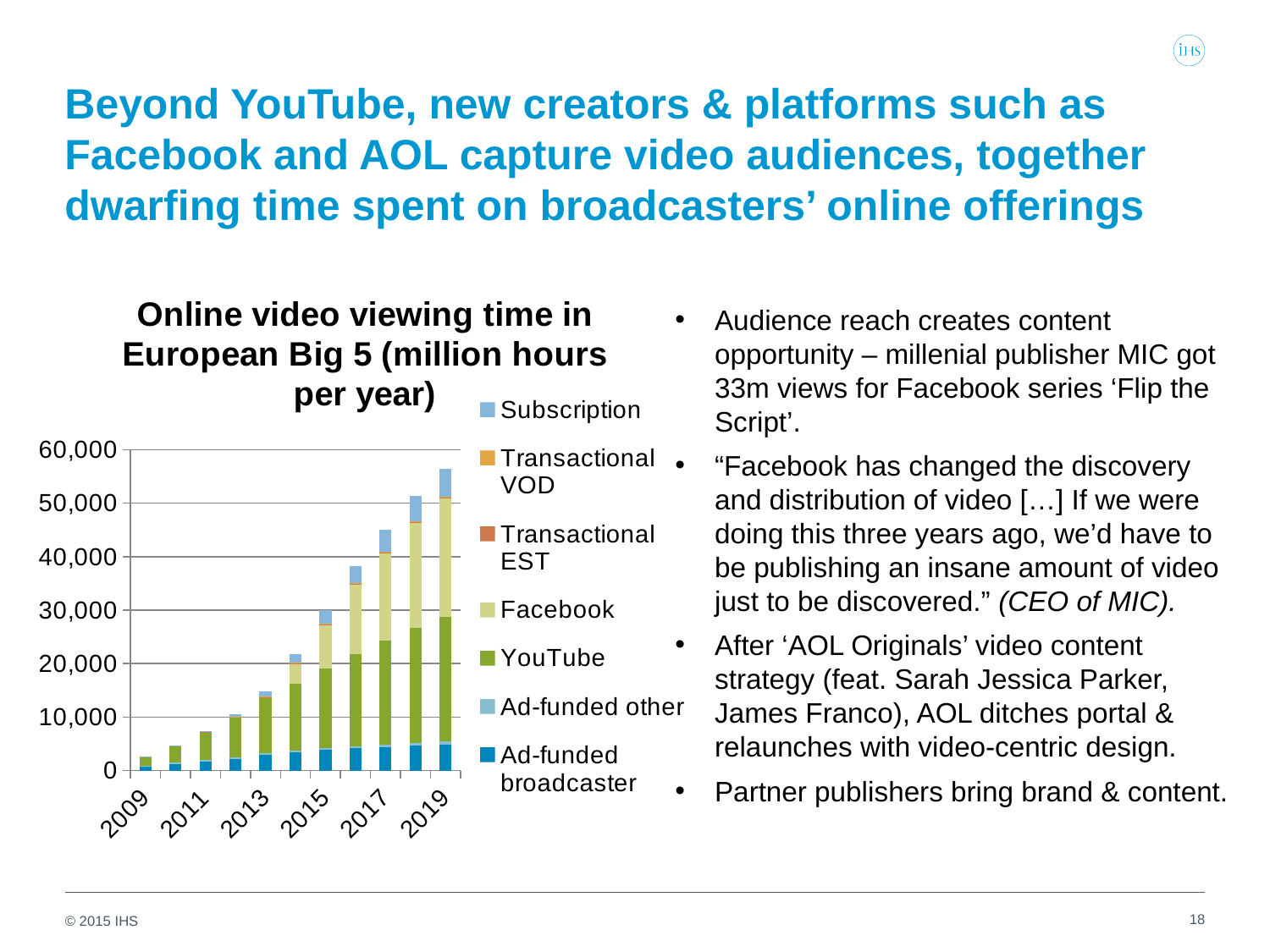
Is the total value for 2009 greater or less than 10,000? less Is the total value for 2017 greater or less than 40,000? greater Is the total value for 2019 greater or less than 50,000? greater What is the title of the chart? Online video viewing time in European Big 5 (million hours per year) How many bars (years) are plotted in the chart? 11 Do the total values rise or fall from 2009 to 2019? Rise Which year has the highest total online video viewing time? 2019 Which year has the lowest total online video viewing time? 2009 Which series is shown in the darkest green colour in the legend? YouTube How many series does the chart's legend list? 7 What kind of chart is shown on the slide? Stacked bar chart Which year has a larger total, 2013 or 2017? 2017